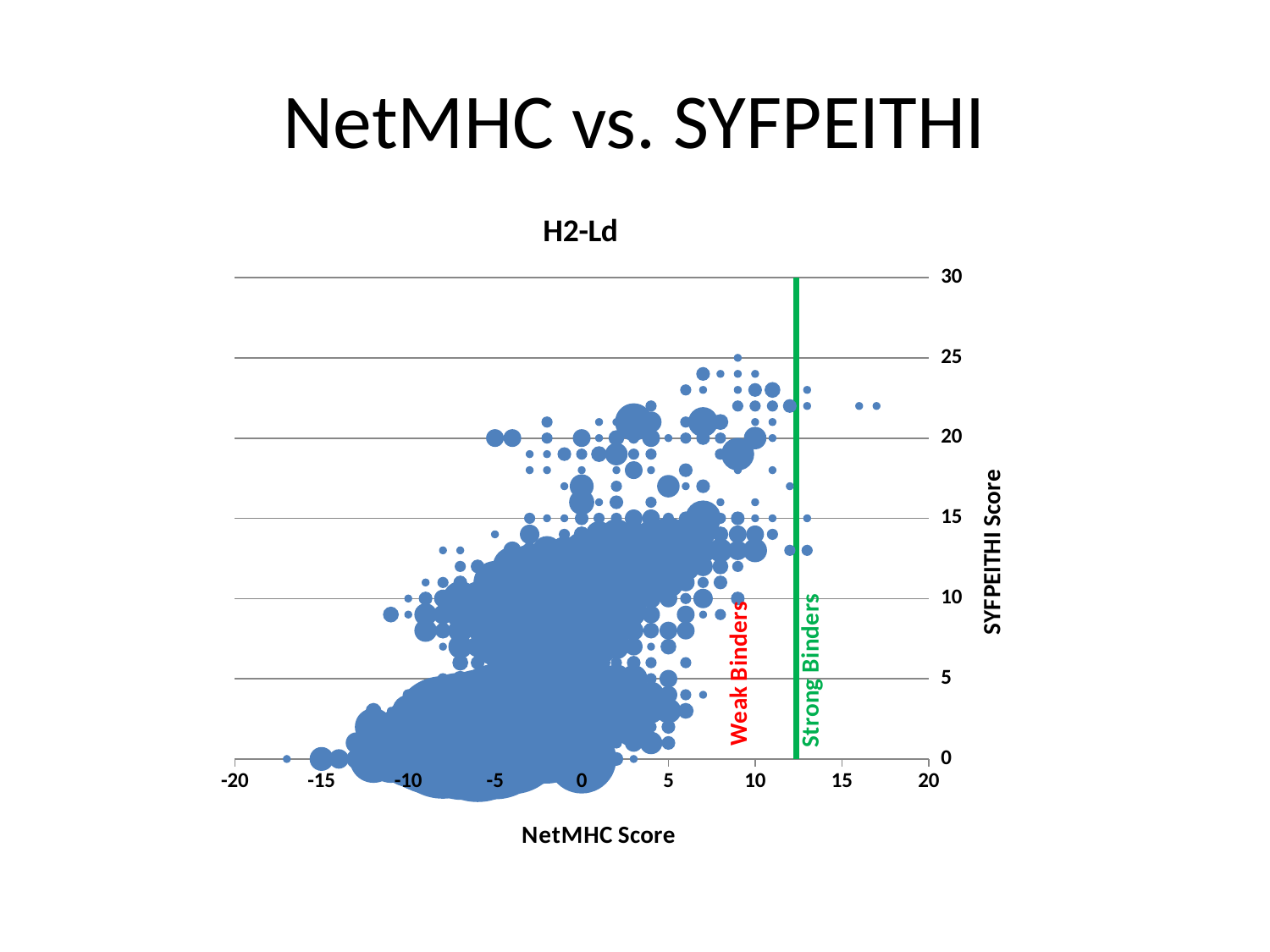
Is the highest NetMHC Score plotted greater or less than 15? greater What is the lowest value shown on the x axis of the chart? -20 As the NetMHC Score increases along the x axis, does the SYFPEITHI Score generally rise or fall? rise Is the highest SYFPEITHI Score plotted greater or less than 30? less What label is on the x axis of the chart? NetMHC Score What is the title of the chart? H2-Ld What kind of chart is shown on the slide? bubble chart Is the NetMHC Score at which the green vertical line is drawn greater or less than 10? greater What is the highest value shown on the y axis of the chart? 30